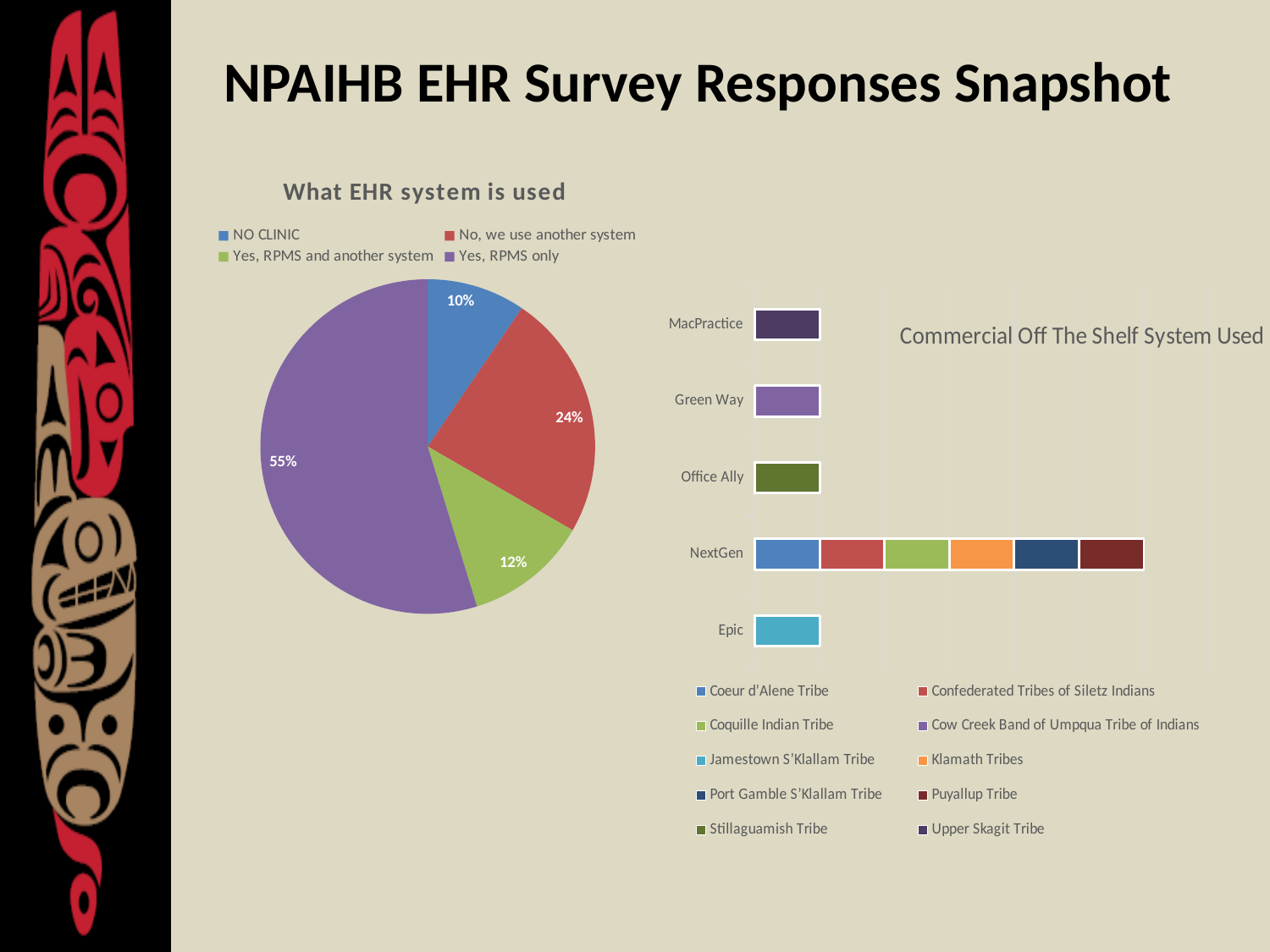
In the chart titled "Commercial Off The Shelf System Used", how many systems are listed on the vertical axis? 5 In the pie chart titled "What EHR system is used", what percentage is shown for "No, we use another system"? 24% In the chart titled "Commercial Off The Shelf System Used", how many tribes does the legend list? 10 In the pie chart titled "What EHR system is used", what share of responses is "Yes, RPMS only"? 55% In the pie chart titled "What EHR system is used", how many slices are there? 4 In the pie chart titled "What EHR system is used", how many percentage points larger is "No, we use another system" than "Yes, RPMS and another system"? 12 percentage points In the pie chart titled "What EHR system is used", what percentage is shown for "NO CLINIC"? 10% What kind of chart is the chart titled "Commercial Off The Shelf System Used"? Bar chart In the pie chart titled "What EHR system is used", which category has the largest slice? Yes, RPMS only What kind of chart is the chart titled "What EHR system is used"? Pie chart In the chart titled "Commercial Off The Shelf System Used", which system has the longest bar? NextGen In the pie chart titled "What EHR system is used", which category has the smallest slice? NO CLINIC